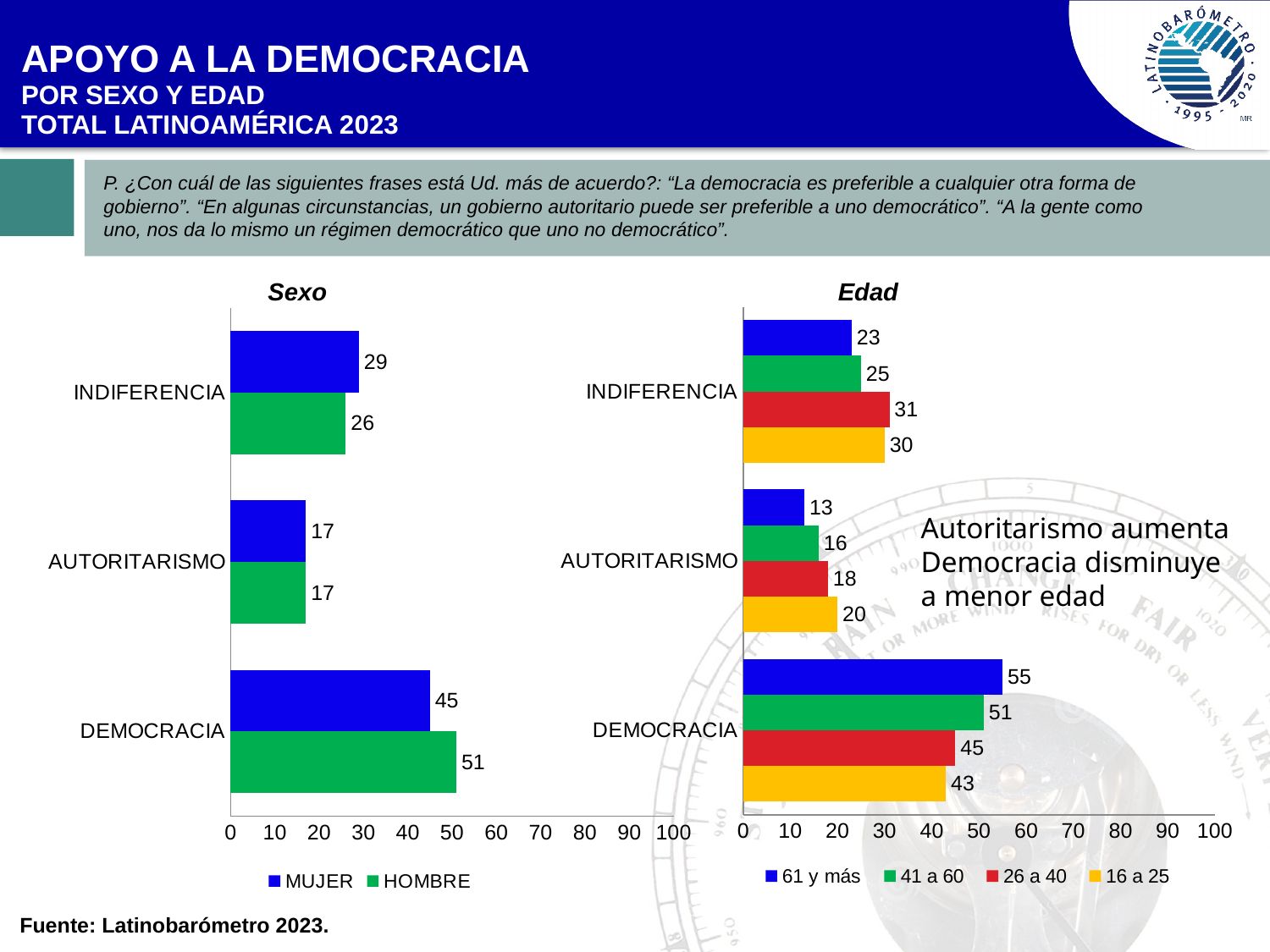
In the 'Edad' chart, what is the value for the 16 a 25 group in the DEMOCRACIA category? 43 In the 'Sexo' chart, which is larger for INDIFERENCIA, MUJER or HOMBRE? MUJER In the 'Sexo' chart, what is the value for MUJER in the DEMOCRACIA category? 45 In the 'Edad' chart, which age group has the highest value for DEMOCRACIA? 61 y más How many series does the legend of the 'Edad' chart list? 4 How many categories are shown in the 'Sexo' chart? 3 In the 'Sexo' chart, what is the value for HOMBRE in the INDIFERENCIA category? 26 In the 'Edad' chart, which age group has the lowest value for INDIFERENCIA? 61 y más In the 'Edad' chart, what is the value for the 61 y más group in the AUTORITARISMO category? 13 In the 'Edad' chart, what is the difference between the 16 a 25 and 61 y más groups in the AUTORITARISMO category? 7 What kind of chart is the 'Sexo' chart? Bar chart In the 'Sexo' chart, what is the difference between HOMBRE and MUJER in the DEMOCRACIA category? 6